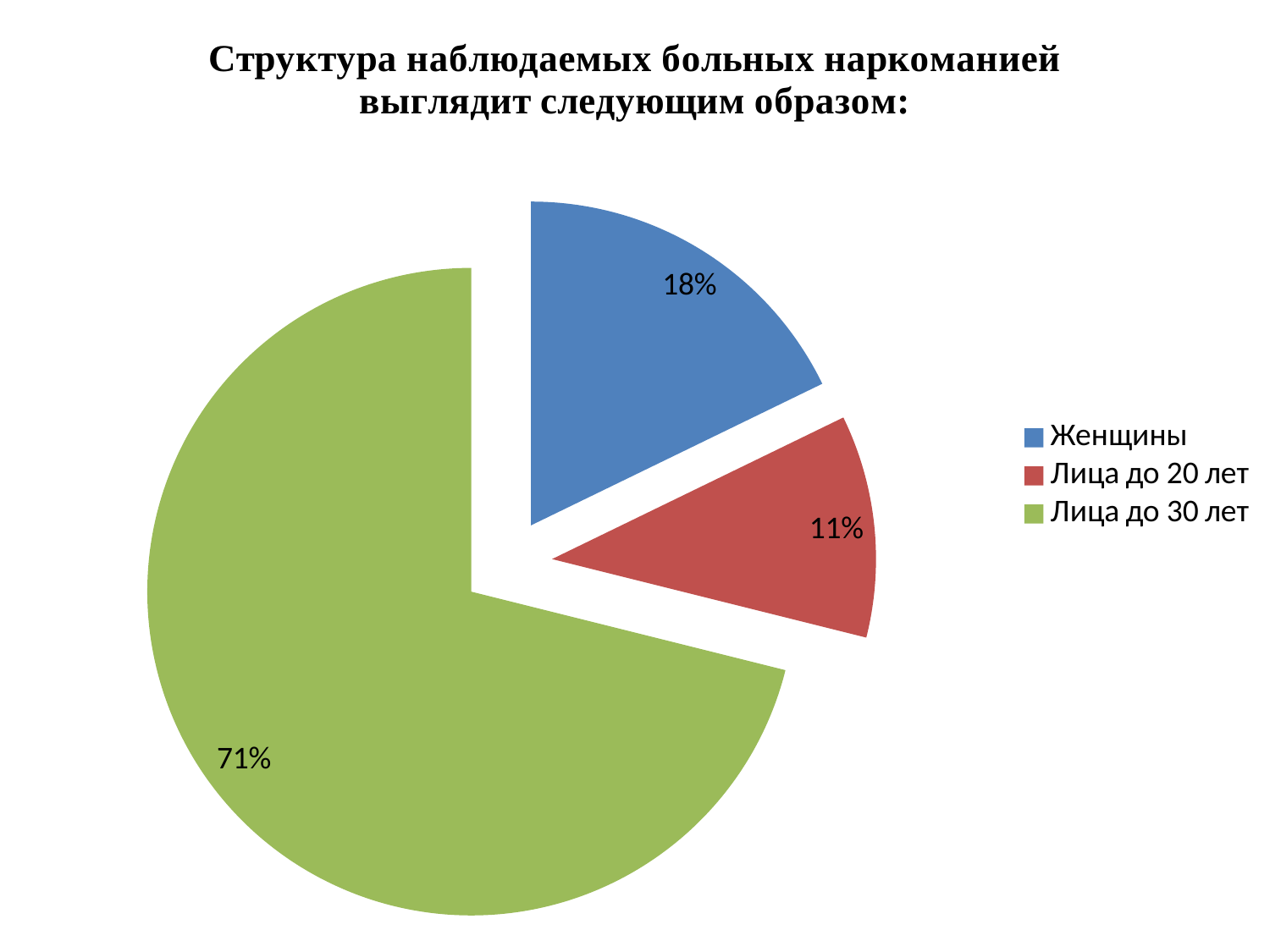
What share of the pie does Женщины represent? 18% What colour is the slice for Лица до 30 лет? Green Which legend entry is shown in blue? Женщины Which is larger, the slice for Женщины or the slice for Лица до 20 лет? Женщины Which category has the smallest slice of the pie? Лица до 20 лет What kind of chart is shown on the slide? Pie chart Which category has the largest slice of the pie? Лица до 30 лет What share of the pie does Лица до 20 лет represent? 11% What is the difference in percentage points between Женщины and Лица до 20 лет? 7 How many slices does the pie chart have? 3 What is the difference in percentage points between Лица до 30 лет and Женщины? 53 What share of the pie does Лица до 30 лет represent? 71%